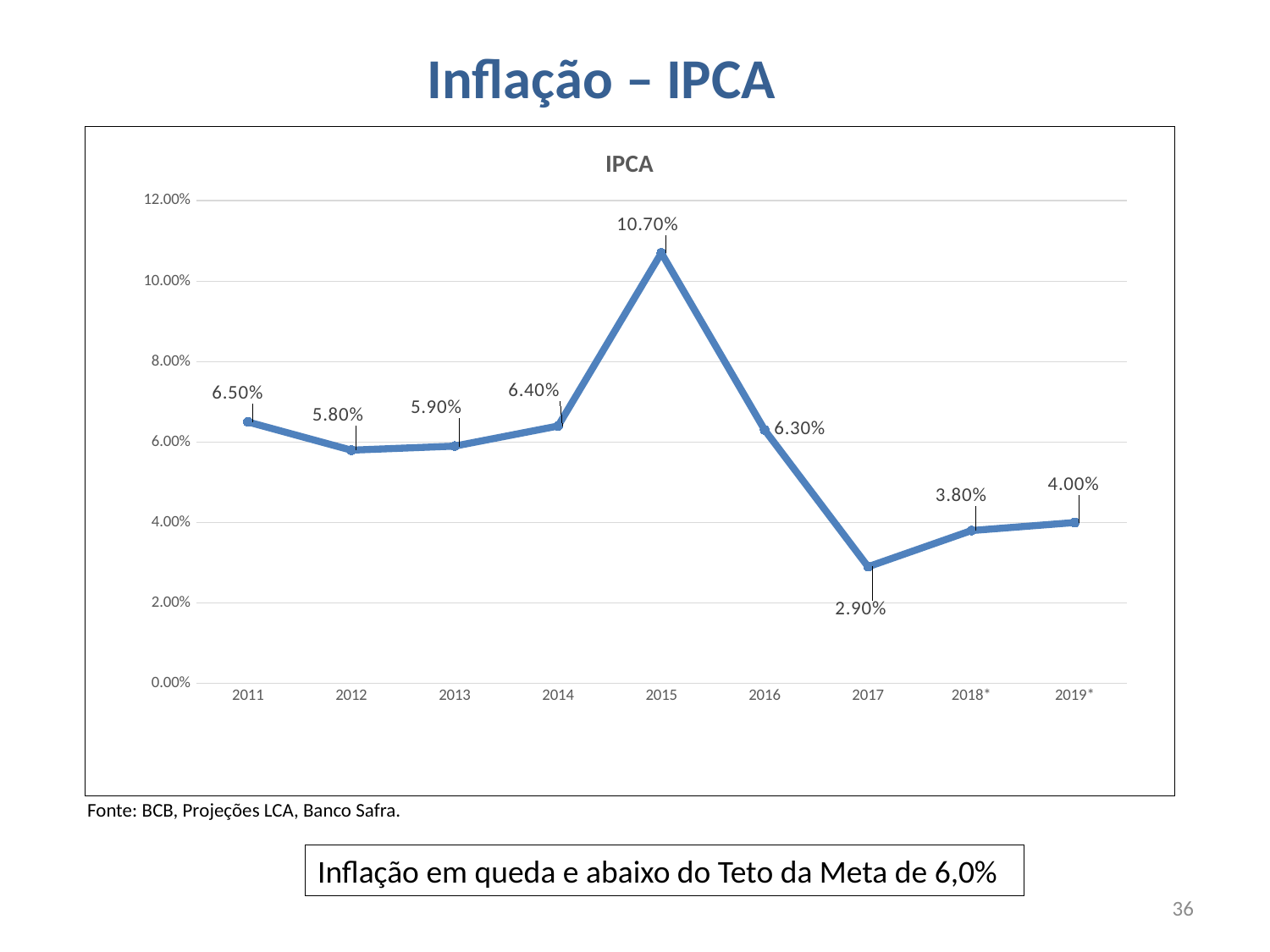
What kind of chart is shown on the slide? line chart What is the IPCA value for 2015? 10.70% Is the IPCA value for 2016 greater or less than 8.00%? less Which is larger, the IPCA value for 2011 or for 2014? 2011 Do the IPCA values rise or fall from 2015 to 2017? fall How many years are plotted on the chart? 9 What is the difference between the IPCA values for 2015 and 2016? 4.40% What is the IPCA value for 2019*? 4.00% What is the IPCA value for 2017? 2.90% Which year has the lowest IPCA value? 2017 Which year has the highest IPCA value? 2015 What is the title of the chart? IPCA